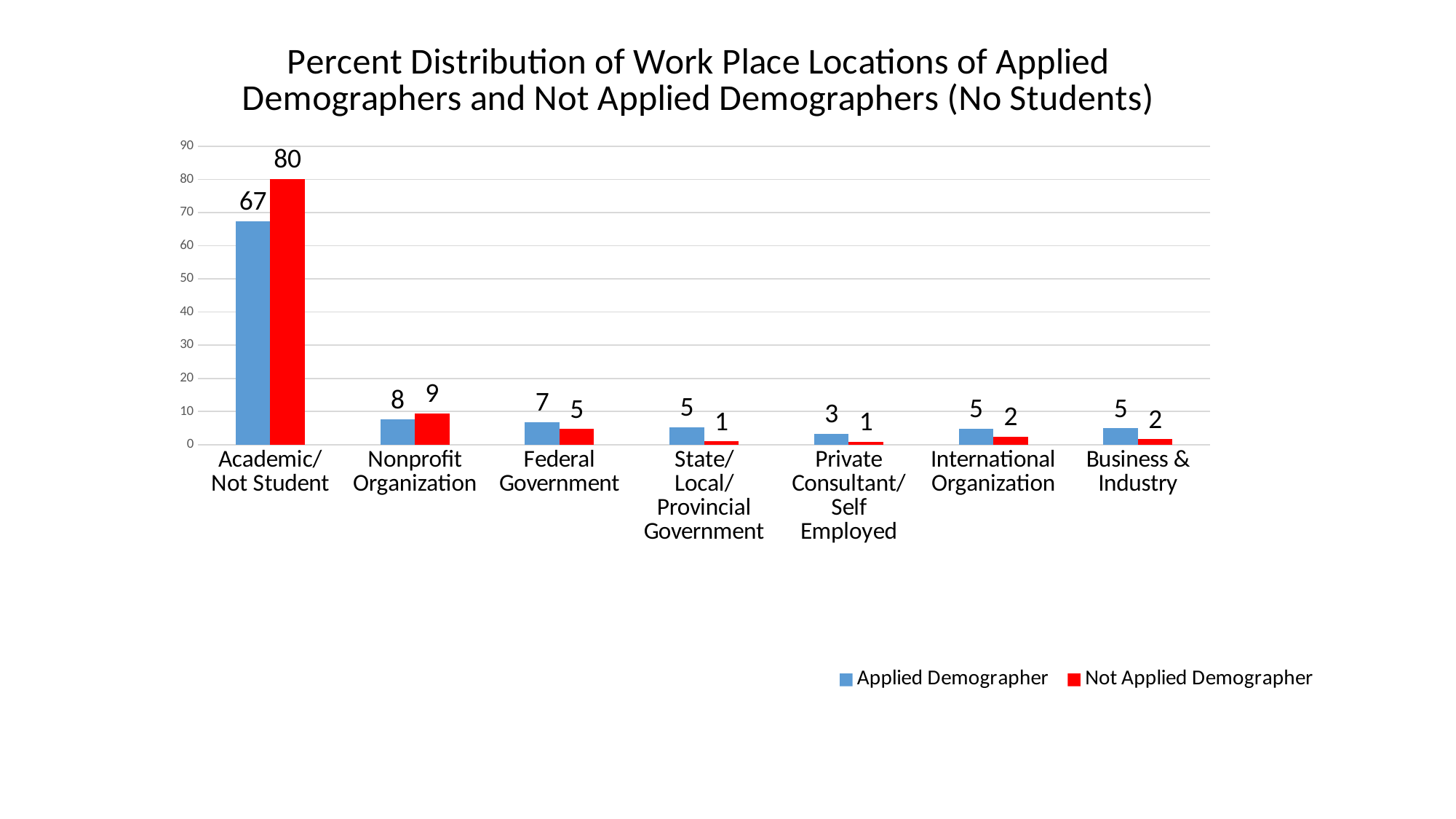
Which colour represents the Not Applied Demographer series? red What is the value for Applied Demographer in the Academic/Not Student category? 67 What is the value for Not Applied Demographer in the Nonprofit Organization category? 9 Which category has the highest value for Not Applied Demographer? Academic/Not Student What is the difference between the Not Applied Demographer and Applied Demographer values in the Academic/Not Student category? 13 How many series does the legend list? 2 How many workplace location categories are shown on the x axis? 7 Is the value for Applied Demographer in the Academic/Not Student category greater or less than 60? greater Which is larger in the Federal Government category: Applied Demographer or Not Applied Demographer? Applied Demographer Which category has the lowest value for Applied Demographer? Private Consultant/Self Employed What kind of chart is shown on the slide? bar chart What is the value for Not Applied Demographer in the Federal Government category? 5